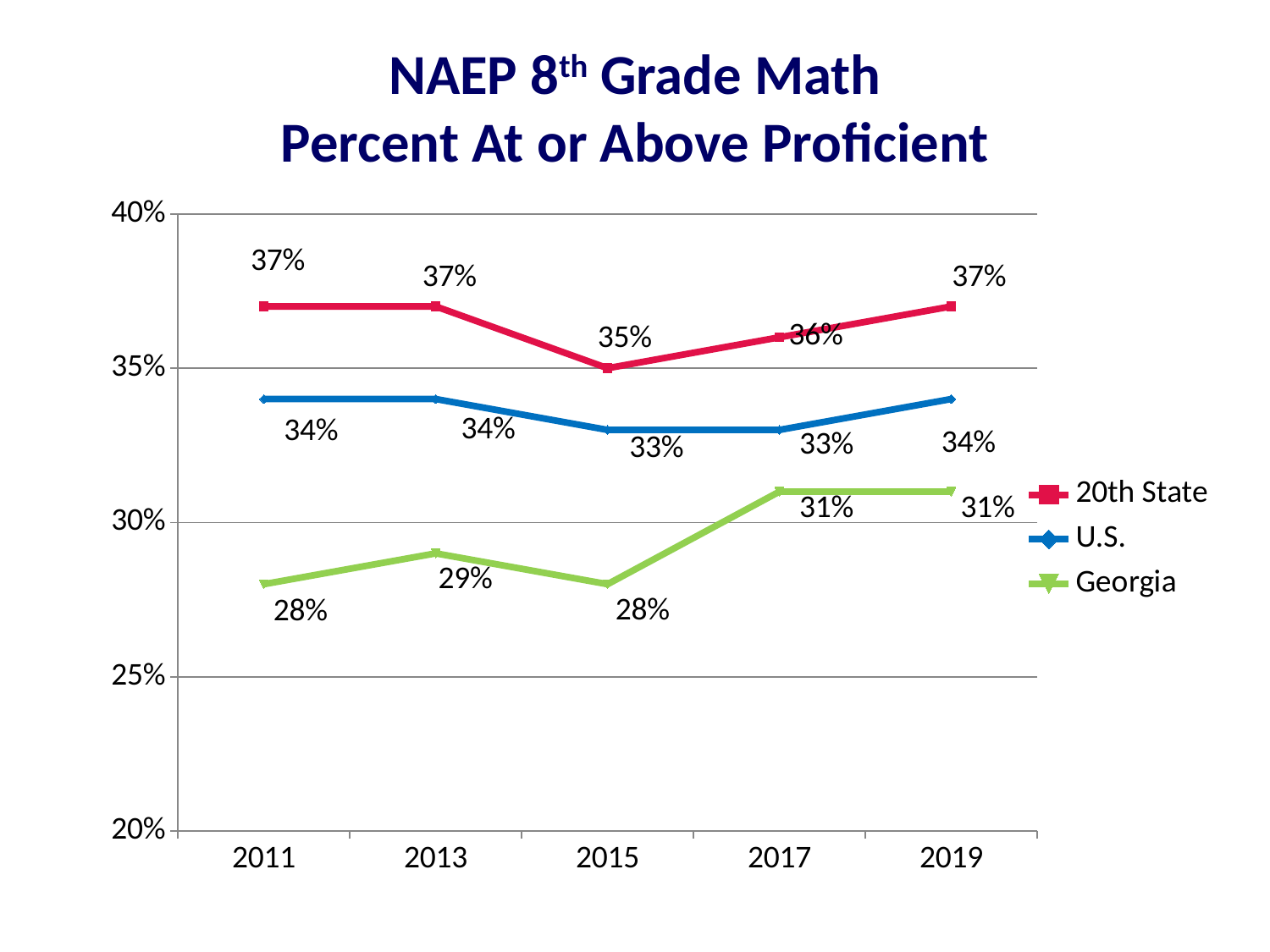
What is the difference between the 20th State value and Georgia's value in 2011? 9 percentage points What was Georgia's percent at or above proficient in 2015? 28% Did Georgia's value rise or fall from 2015 to 2017? Rise How many series does the legend list? 3 In which year was the 20th State value lowest? 2015 In which year was Georgia's value lowest? 2011 and 2015 What kind of chart is this? Line chart How many years are shown on the x axis? 5 Which was higher in 2017, the U.S. or Georgia? U.S. What was the 20th State value in 2017? 36% What was the U.S. value in 2019? 34% What is the difference between the U.S. value and Georgia's value in 2019? 3 percentage points